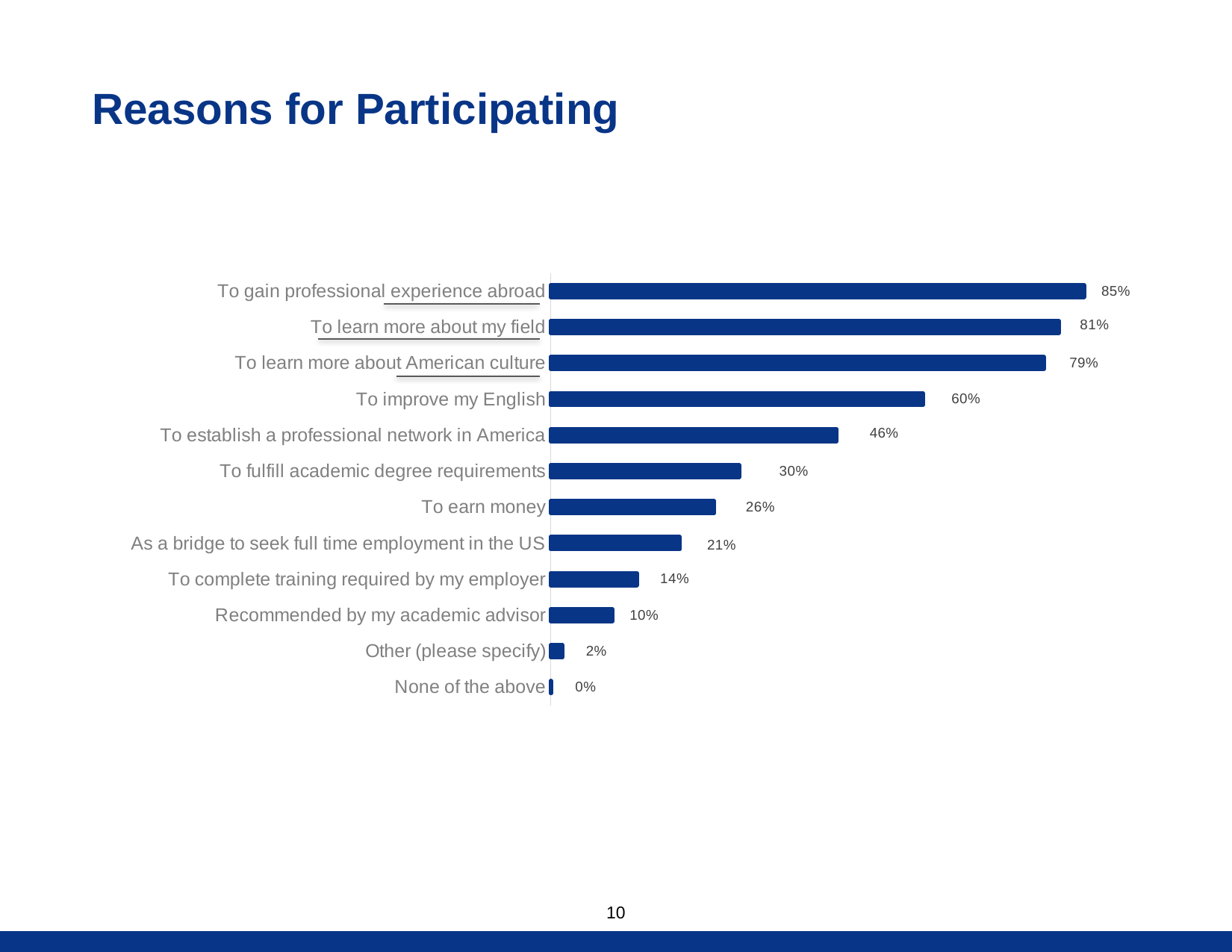
What type of chart is shown on the slide? Bar chart What is the value shown for "To earn money"? 26% What percentage of respondents chose "To improve my English" as a reason for participating? 60% What percentage is shown for "Recommended by my academic advisor"? 10% What is the title of the slide containing the chart? Reasons for Participating Which is larger: "As a bridge to seek full time employment in the US" or "To complete training required by my employer"? As a bridge to seek full time employment in the US What is the value shown for "Other (please specify)"? 2% What is the difference between "To learn more about my field" and "To learn more about American culture"? 2% Which reason for participating has the highest percentage? To gain professional experience abroad Which category has the lowest value on the chart? None of the above How much higher is "To establish a professional network in America" than "To fulfill academic degree requirements"? 16% How many reasons (categories) are listed on the chart? 12